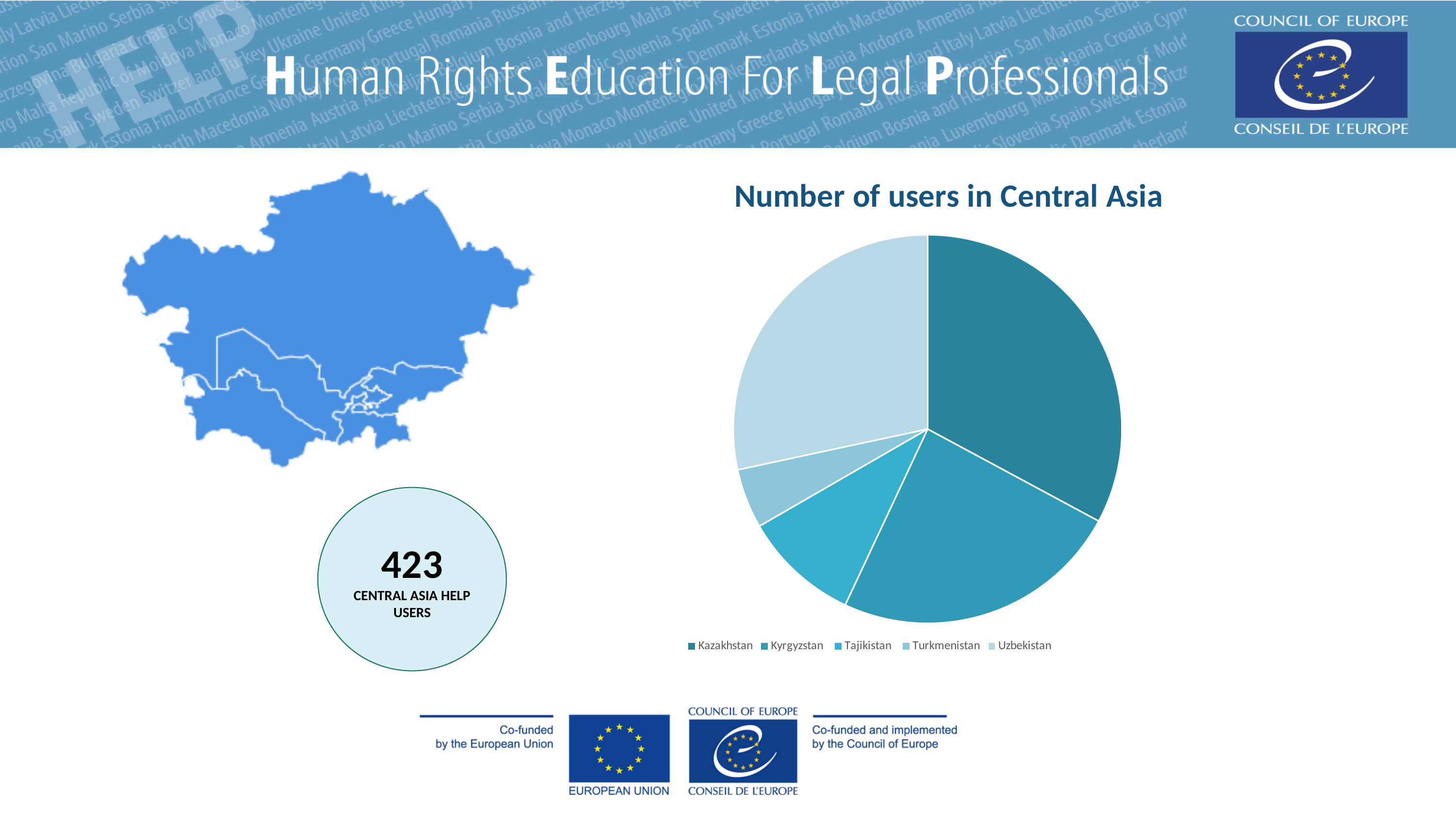
In the pie chart, which has more users, Kazakhstan or Tajikistan? Kazakhstan How many countries (slices) are shown in the pie chart? 5 Which country has the largest slice in the pie chart? Kazakhstan In the pie chart, which has more users, Tajikistan or Turkmenistan? Tajikistan In the pie chart, which has more users, Kazakhstan or Kyrgyzstan? Kazakhstan What kind of chart is used to show the number of users in Central Asia? Pie chart What is the title of the pie chart? Number of users in Central Asia Which country has the smallest slice in the pie chart? Turkmenistan How many entries does the legend of the pie chart list? 5 Which country is listed first in the legend of the pie chart? Kazakhstan